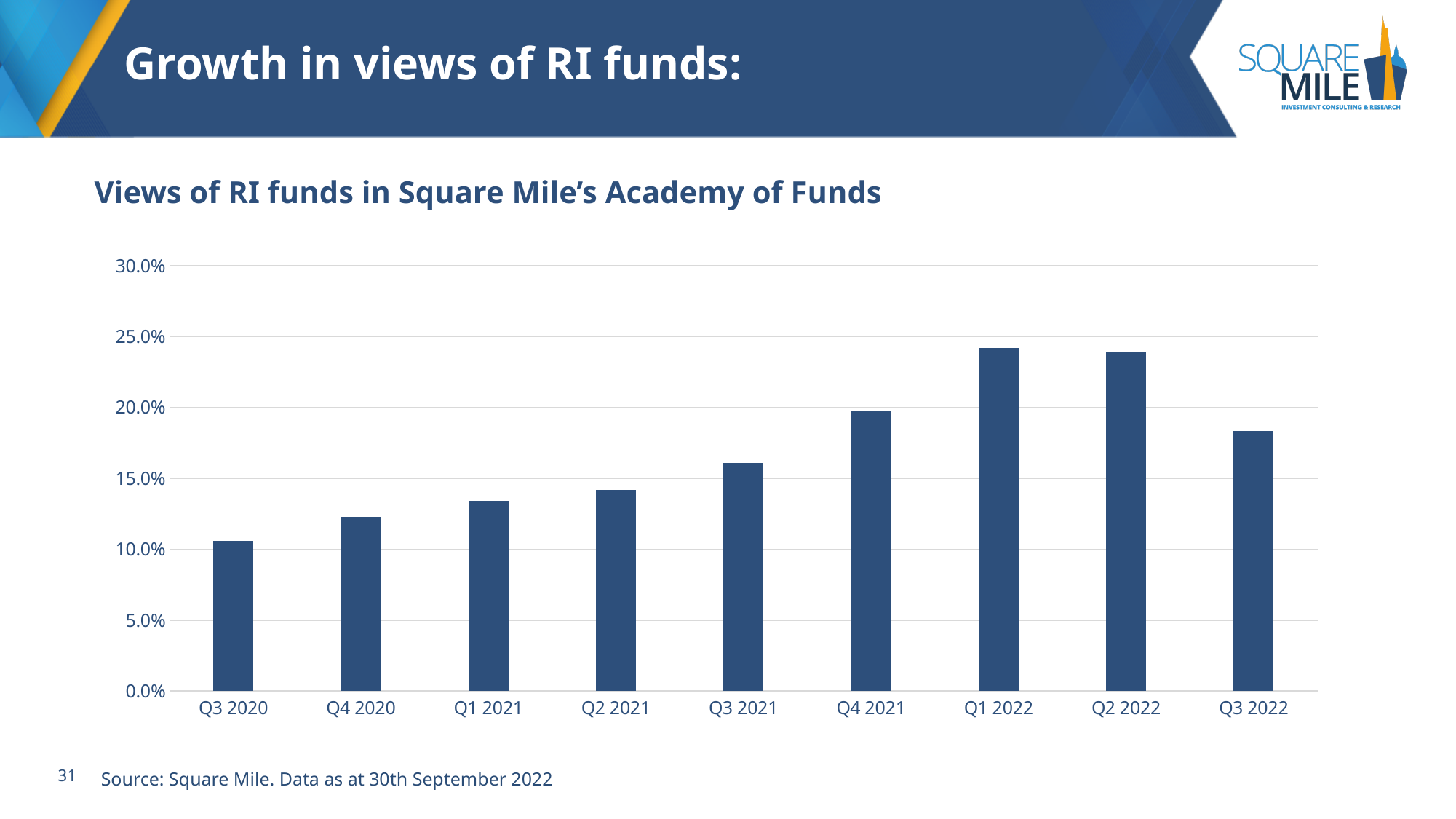
Which quarter has the lowest value in the chart? Q3 2020 Which is larger, the value for Q4 2021 or the value for Q3 2022? Q4 2021 Which is larger, the value for Q2 2022 or the value for Q3 2022? Q2 2022 Is the value for Q3 2020 greater or less than 10.0%? greater Is the value for Q3 2021 greater or less than 15.0%? greater Do the values rise or fall from Q3 2020 to Q1 2022? Rise Is the value for Q2 2021 greater or less than 15.0%? less What is the title of the chart? Views of RI funds in Square Mile's Academy of Funds How many quarters are plotted on the x axis of the chart? 9 What kind of chart is shown on the slide? Bar chart